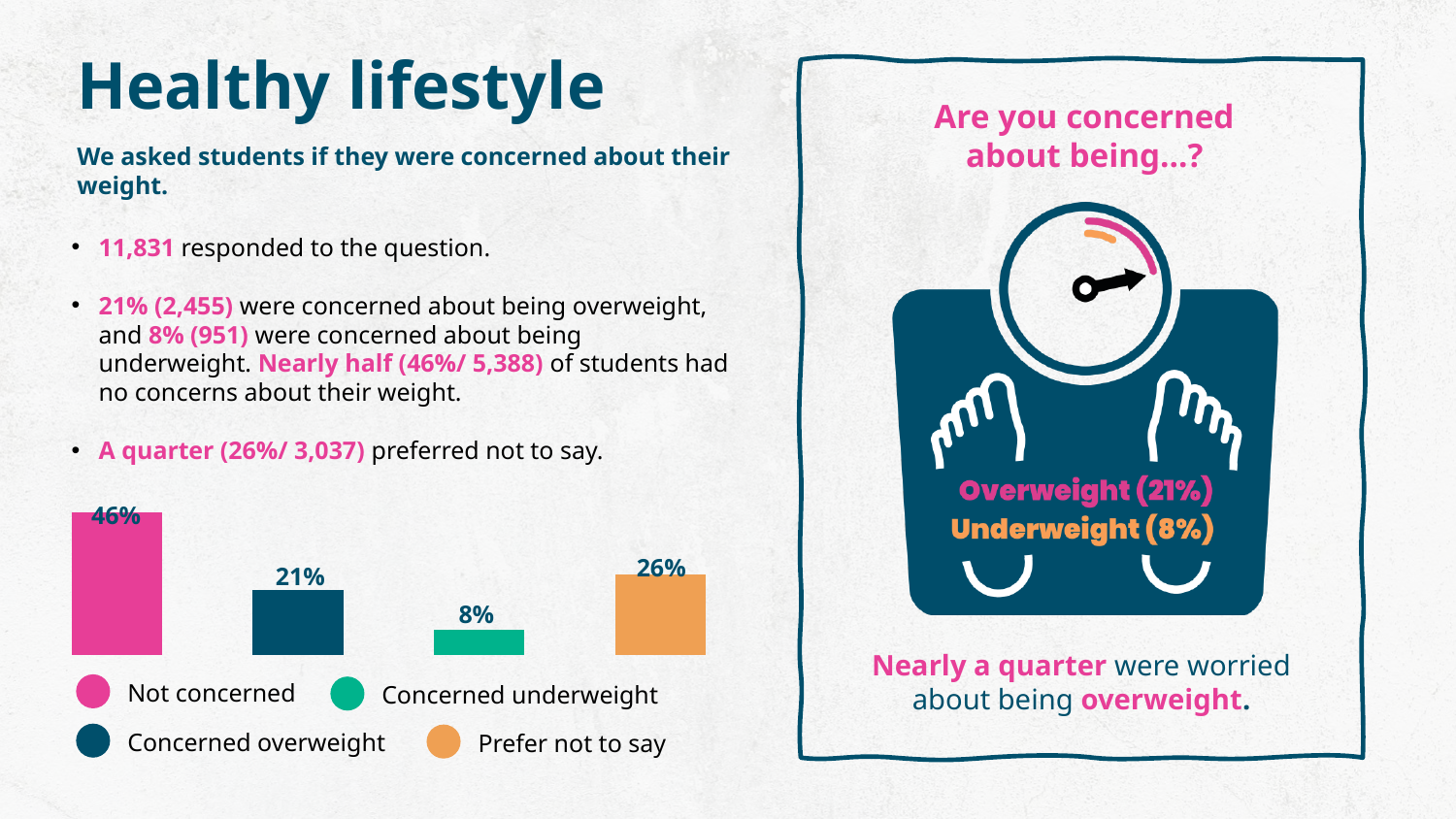
What is the difference between the 'Concerned overweight' and 'Concerned underweight' values in the bar chart? 13% What type of chart is shown on the slide? Bar chart What percentage of students preferred not to say, according to the bar chart? 26% Which category has the highest value in the bar chart? Not concerned What value does the bar chart show for 'Concerned underweight'? 8% How many categories are shown in the bar chart? 4 What value does the bar chart show for 'Concerned overweight'? 21% Which category has the lowest value in the bar chart? Concerned underweight What is the difference between the 'Not concerned' and 'Prefer not to say' values in the bar chart? 20% Which is larger in the bar chart: 'Prefer not to say' or 'Concerned overweight'? Prefer not to say What percentage of students were not concerned about their weight according to the bar chart? 46% What colour is the 'Not concerned' bar in the chart? Pink